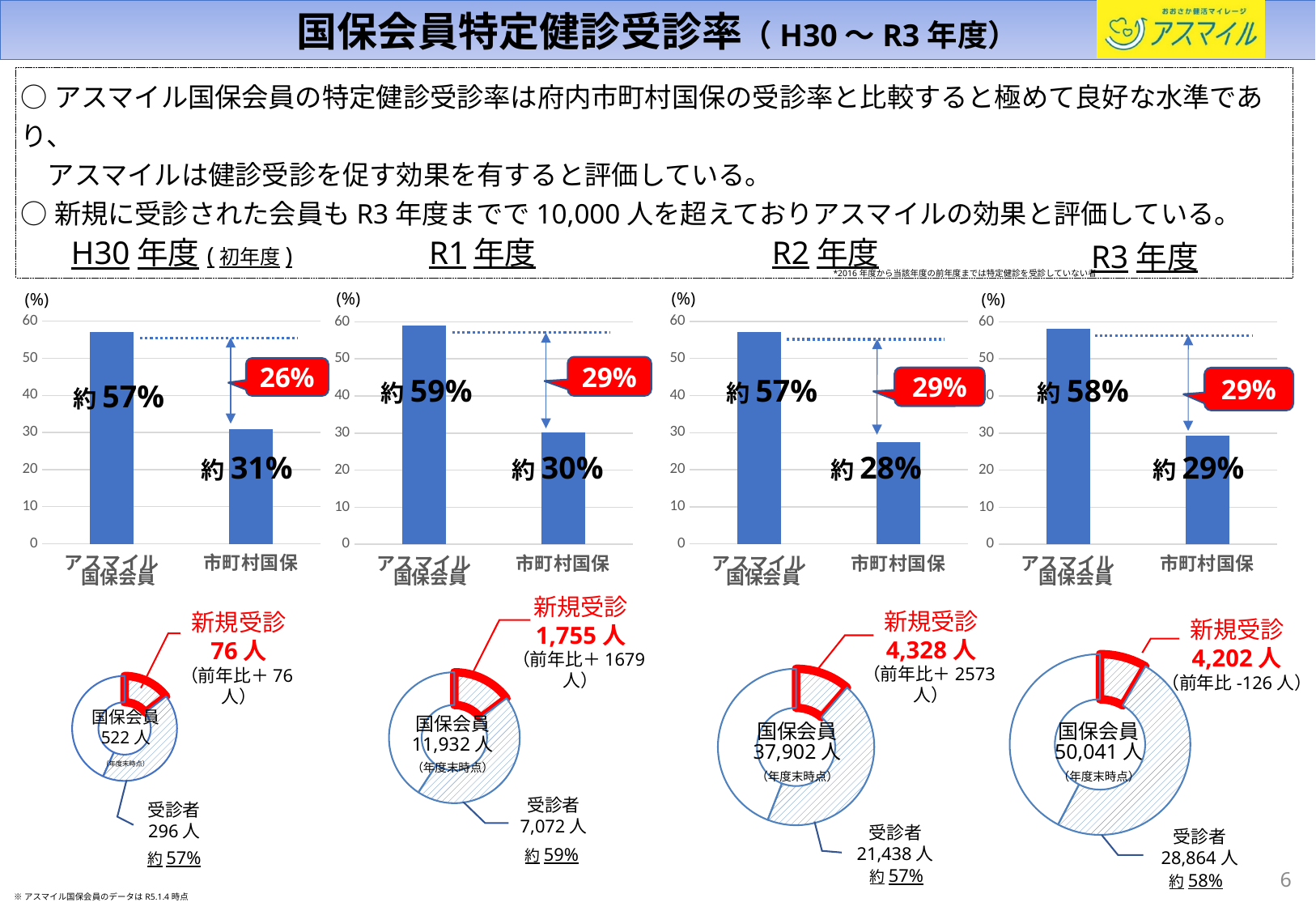
In the R3年度 bar chart, which category has the higher bar, アスマイル国保会員 or 市町村国保? アスマイル国保会員 In the R1年度 bar chart, what is the value labelled for アスマイル国保会員? 約59% In the R3年度 bar chart, what is the value labelled for 市町村国保? 約29% In the R1年度 bar chart, what difference between the two bars is shown in the red callout? 29% In the R2年度 bar chart, is the value for 市町村国保 greater or less than 30? less In the H30年度 bar chart, what difference between the two bars is shown in the red callout? 26% What kind of chart is used for each 年度 in the upper row of the slide? bar chart In the H30年度 bar chart, what is the value labelled for アスマイル国保会員? 約57% In the H30年度 bar chart, what is the value labelled for 市町村国保? 約31% In the R3年度 donut chart, how many 国保会員 are shown? 50,041人 In the R1年度 donut chart, how many 新規受診 people are shown? 1,755人 In the R2年度 bar chart, what is the value labelled for 市町村国保? 約28%